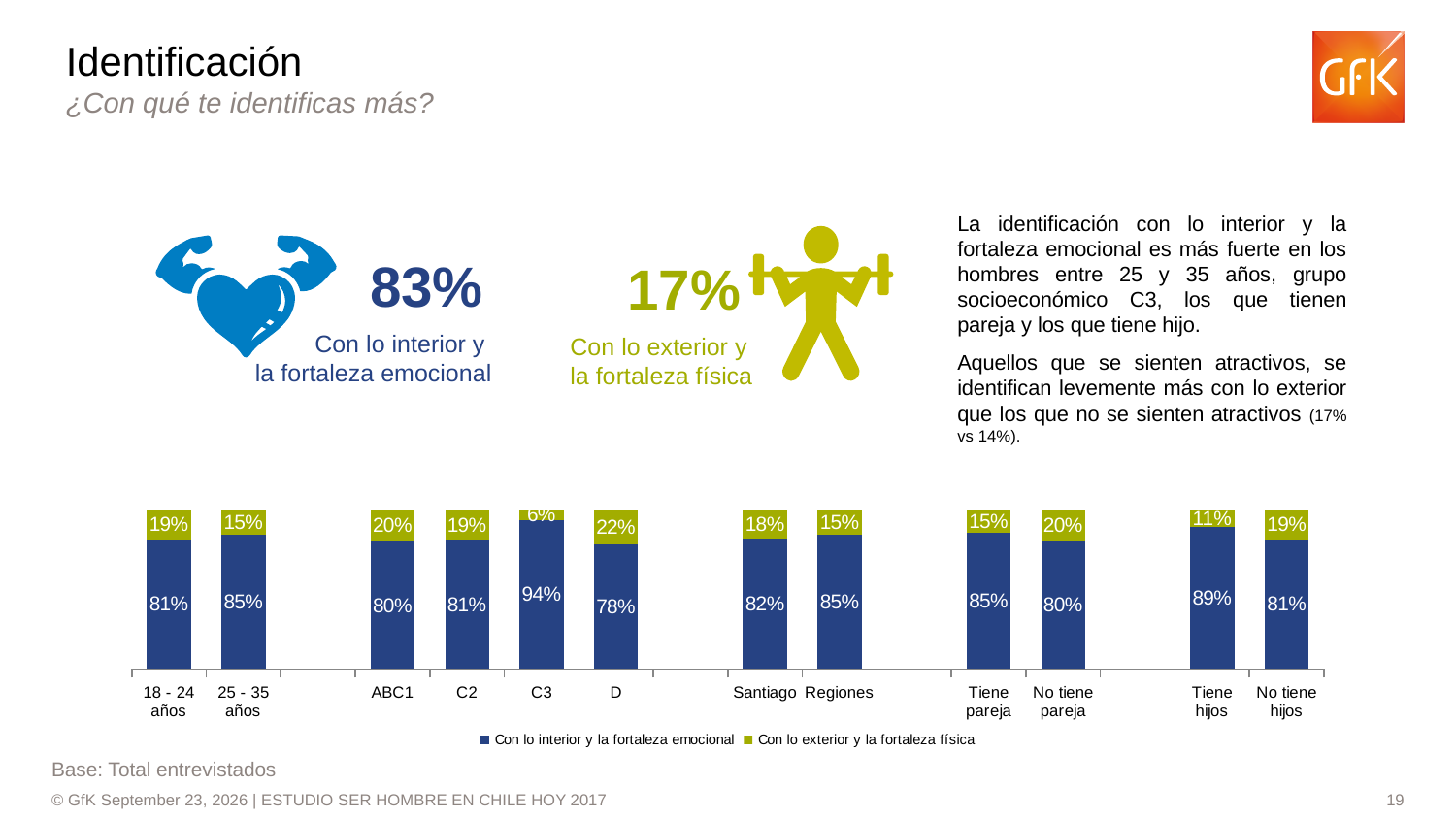
What is the total of the stacked bar for ABC1? 100% What is the value of 'Con lo interior y la fortaleza emocional' for the 25 - 35 años category? 85% What is the difference between the 'Con lo interior y la fortaleza emocional' values for Santiago and Regiones? 3% What is the value of 'Con lo exterior y la fortaleza física' for No tiene pareja? 20% Which category has the lowest value for 'Con lo interior y la fortaleza emocional'? D What is the value of 'Con lo exterior y la fortaleza física' for the D category? 22% Which has a larger 'Con lo exterior y la fortaleza física' value, 18 - 24 años or 25 - 35 años? 18 - 24 años How many series does the chart legend list? 2 How many categories are shown along the x axis of the chart? 12 Which category has the highest value for 'Con lo interior y la fortaleza emocional'? C3 What kind of chart is shown on the slide? Stacked bar chart What is the value of 'Con lo interior y la fortaleza emocional' for Tiene hijos? 89%